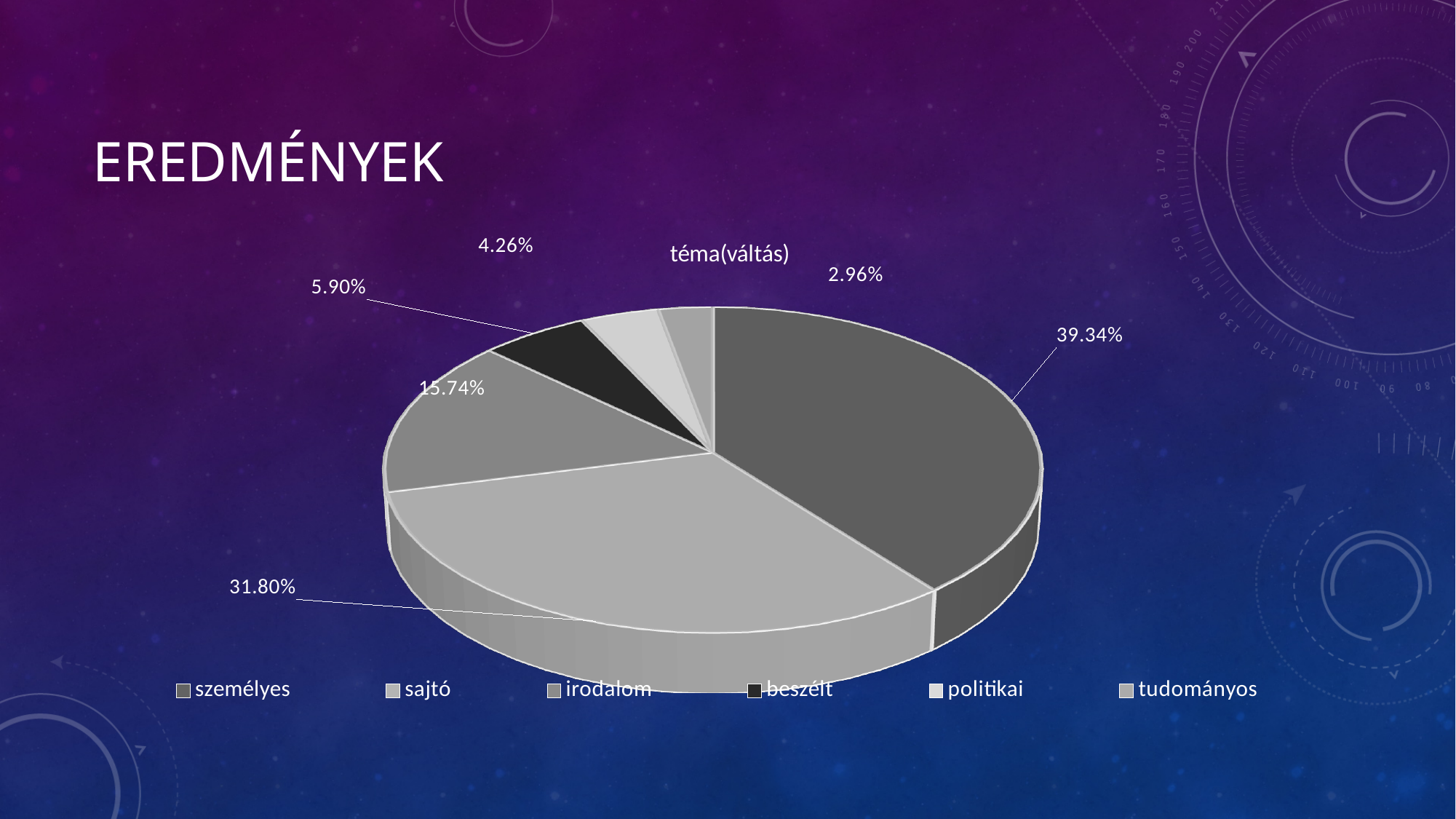
What is the value shown for 'tudományos'? 2.96% How many categories does the legend of the pie chart list? 6 What kind of chart is shown on the slide? pie chart What is the value shown for 'beszélt'? 5.90% What is the difference between the 'személyes' and 'sajtó' shares? 7.54% What share of the pie does the 'személyes' slice have? 39.34% Which is larger, the 'politikai' slice or the 'beszélt' slice? beszélt Which category has the smallest slice of the pie? tudományos What share of the pie does the 'sajtó' slice have? 31.80% What is the title of the chart? téma(váltás) Which category has the largest slice of the pie? személyes What is the value shown for 'irodalom'? 15.74%